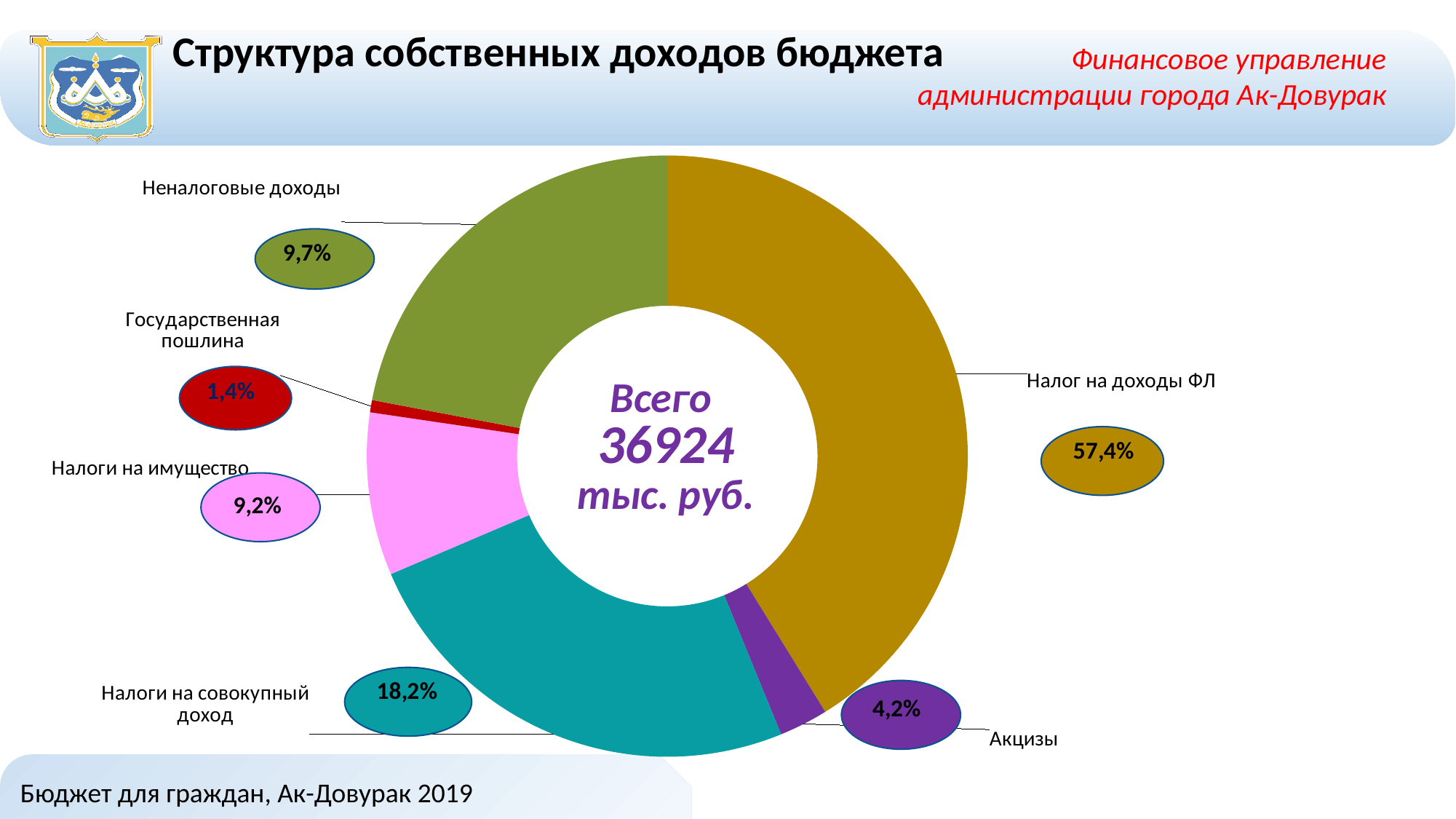
Which category has the largest share of the budget's own revenues? Налог на доходы ФЛ What total amount is shown in the centre of the chart? 36924 тыс. руб. Which is larger: the share for Неналоговые доходы or the share for Налоги на имущество? Неналоговые доходы What share of the budget's own revenues comes from Налог на доходы ФЛ? 57,4% How many categories are shown in the chart? 6 What percentage is shown for Акцизы? 4,2% What percentage is shown for Государственная пошлина? 1,4% What is the difference in percentage points between Налог на доходы ФЛ and Налоги на совокупный доход? 39,2 What kind of chart is shown on the slide? Doughnut (pie) chart What percentage is shown for Налоги на совокупный доход? 18,2% Which category has the smallest share of the budget's own revenues? Государственная пошлина What percentage is shown for Неналоговые доходы? 9,7%